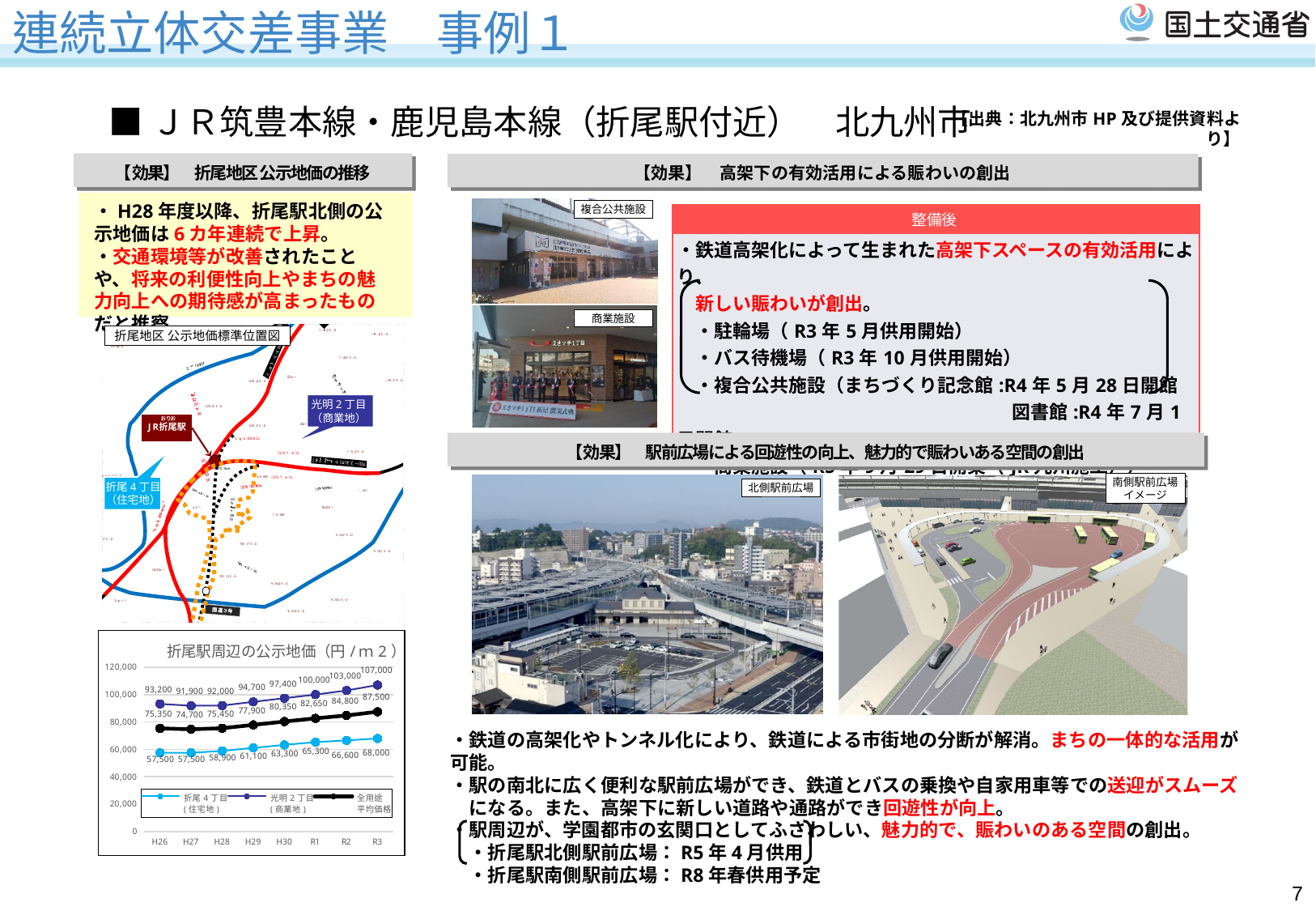
In the 折尾駅周辺の公示地価 chart, what is the 全用途平均価格 value in H30? 80,350 How many series does the legend of the 折尾駅周辺の公示地価 chart list? 3 In the 折尾駅周辺の公示地価 chart, which series has the larger value in R1: 全用途平均価格 or 折尾4丁目（住宅地）? 全用途平均価格 In the 折尾駅周辺の公示地価 chart, what is the value for 光明2丁目（商業地） in R3? 107,000 In the 折尾駅周辺の公示地価 chart, what is the difference between the 光明2丁目（商業地） value and the 折尾4丁目（住宅地） value in R3? 39,000 In the 折尾駅周辺の公示地価 chart, does the 折尾4丁目（住宅地） series rise or fall from H28 to R3? rise What type of chart is 折尾駅周辺の公示地価（円/m２）? line chart In the 折尾駅周辺の公示地価 chart, which year has the highest value for 全用途平均価格? R3 In the 折尾駅周辺の公示地価 chart, is the 光明2丁目（商業地） value in R2 greater or less than 100,000? greater In the 折尾駅周辺の公示地価 chart, what is the value for 折尾4丁目（住宅地） in H26? 57,500 How many years are shown on the x axis of the 折尾駅周辺の公示地価 chart? 8 In the 折尾駅周辺の公示地価 chart, which year has the lowest value for 光明2丁目（商業地）? H27